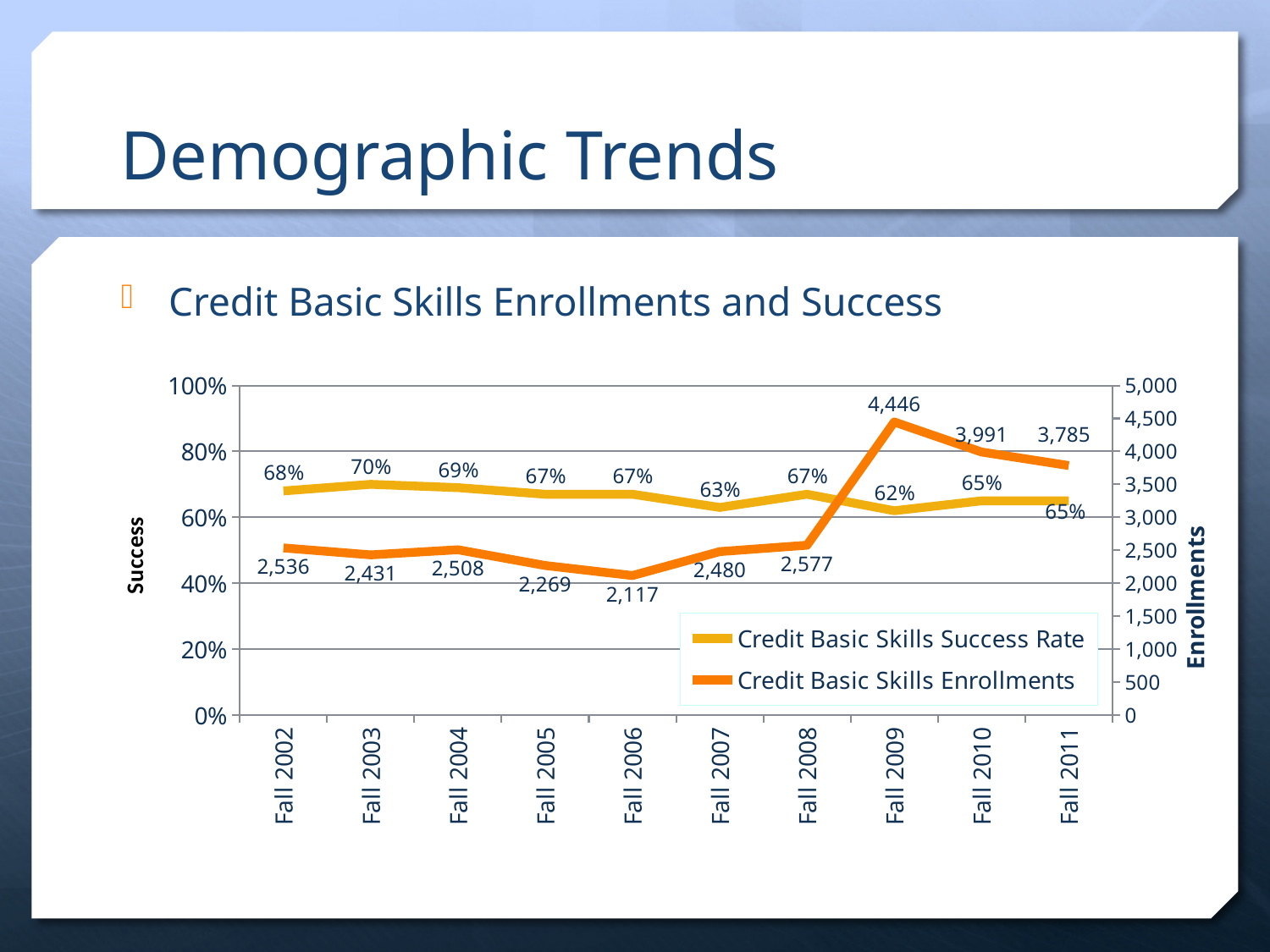
In which term were Credit Basic Skills Enrollments lowest? Fall 2006 What was the Credit Basic Skills Enrollments value in Fall 2009? 4,446 How many series does the legend list? 2 In which term was the Credit Basic Skills Success Rate lowest? Fall 2009 Which term had higher Credit Basic Skills Enrollments, Fall 2010 or Fall 2011? Fall 2010 In which term were Credit Basic Skills Enrollments highest? Fall 2009 What kind of chart is shown on the slide? Line chart What was the Credit Basic Skills Success Rate in Fall 2003? 70% What was the Credit Basic Skills Enrollments value in Fall 2006? 2,117 What is the difference in Credit Basic Skills Enrollments between Fall 2009 and Fall 2008? 1,869 How many terms are shown on the x axis? 10 What is the label of the right-hand vertical axis? Enrollments